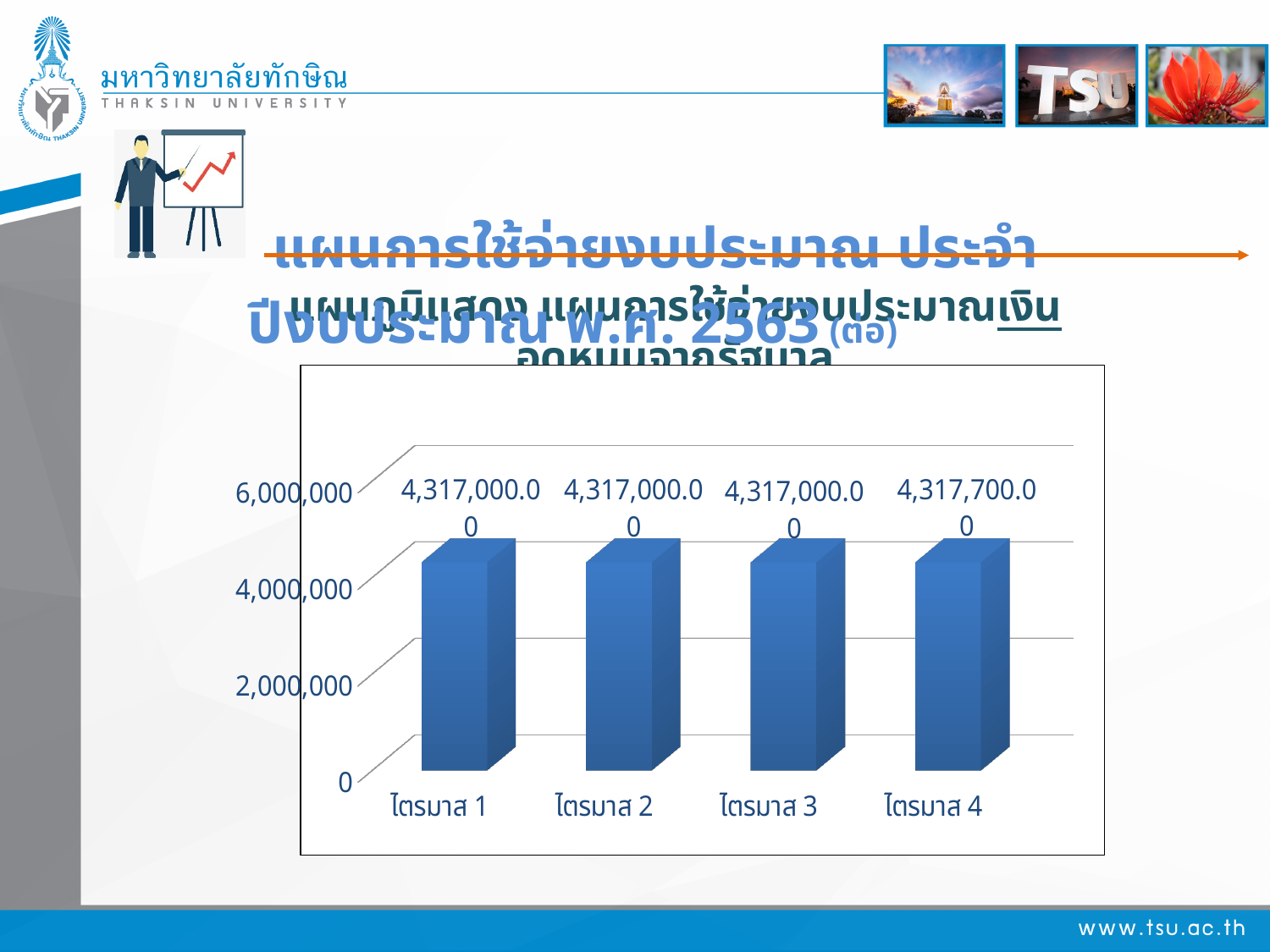
What is the difference between the values for ไตรมาส 4 and ไตรมาส 1? 700.00 What colour are the bars in the chart? blue Is the value for ไตรมาส 3 greater or less than 6,000,000? less What is the value for ไตรมาส 4? 4,317,700.00 How many categories (quarters) are shown on the x axis? 4 Do the values change noticeably from ไตรมาส 1 to ไตรมาส 4, or stay roughly flat? roughly flat Which quarter has the highest value according to the data labels? ไตรมาส 4 What is the value for ไตรมาส 1? 4,317,000.00 What is the highest tick value shown on the vertical axis? 6,000,000 What kind of chart is shown on the slide? bar chart Is the value for ไตรมาส 2 greater or less than 4,000,000? greater What is the value for ไตรมาส 3? 4,317,000.00